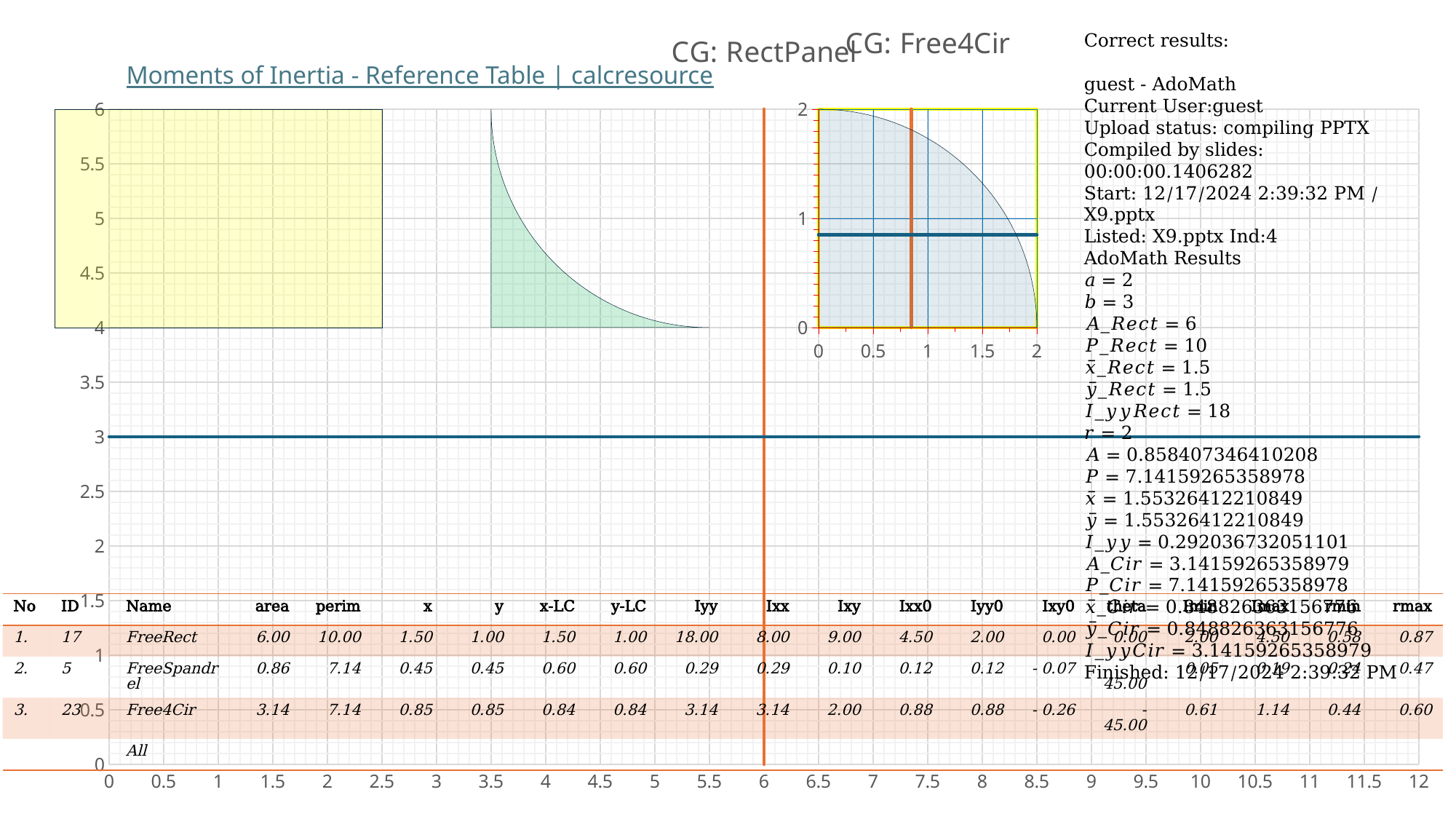
On the main grid chart, is the right end of the green spandrel shape at an x value greater or less than 5? greater On the main grid chart, at which y-axis value does the horizontal dark blue line sit? 3 On the inset chart titled CG: Free4Cir, is the horizontal dark blue line at a y value greater or less than 1? less On the main grid chart, what is the largest tick value shown on the y axis? 6 On the main grid chart, what x value does the right edge of the yellow rectangle reach? 2.5 On the main grid chart, what y value is the bottom edge of the yellow rectangle on? 4 On the main grid chart, what y value does the top edge of the yellow rectangle reach? 6 On the main grid chart, at which x-axis value does the vertical orange line sit? 6 On the inset chart titled CG: Free4Cir, is the vertical orange line at an x value greater or less than 1? less In the table below the chart, which shape has the largest area value? FreeRect On the main grid chart, what is the largest tick value shown on the x axis? 12